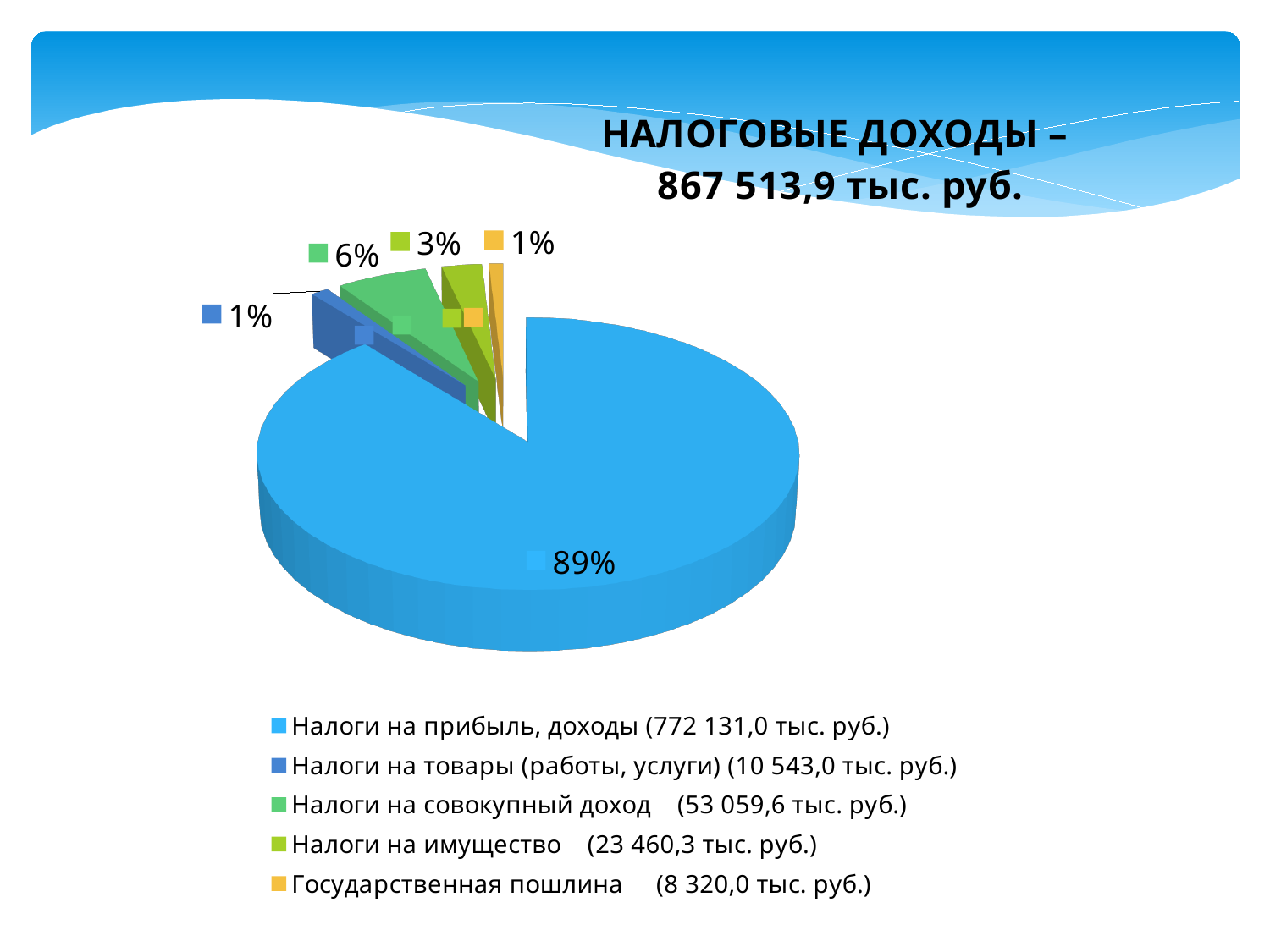
Which category has the largest slice of the pie? Налоги на прибыль, доходы According to the legend, what amount is given for "Налоги на товары (работы, услуги)"? 10 543,0 тыс. руб. How many entries does the legend list? 5 What share of the pie is labelled for "Налоги на имущество"? 3% What share of the pie is labelled for "Налоги на прибыль, доходы"? 89% How many slices does the pie chart have? 5 What share of the pie is labelled for "Налоги на совокупный доход"? 6% Which is larger: the slice for "Налоги на совокупный доход" or the slice for "Налоги на имущество"? Налоги на совокупный доход What is the difference in percentage points between the "Налоги на прибыль, доходы" slice and the "Налоги на совокупный доход" slice? 83 percentage points What kind of chart is shown on the slide? pie chart What total amount of tax revenue is stated in the chart title? 867 513,9 тыс. руб.